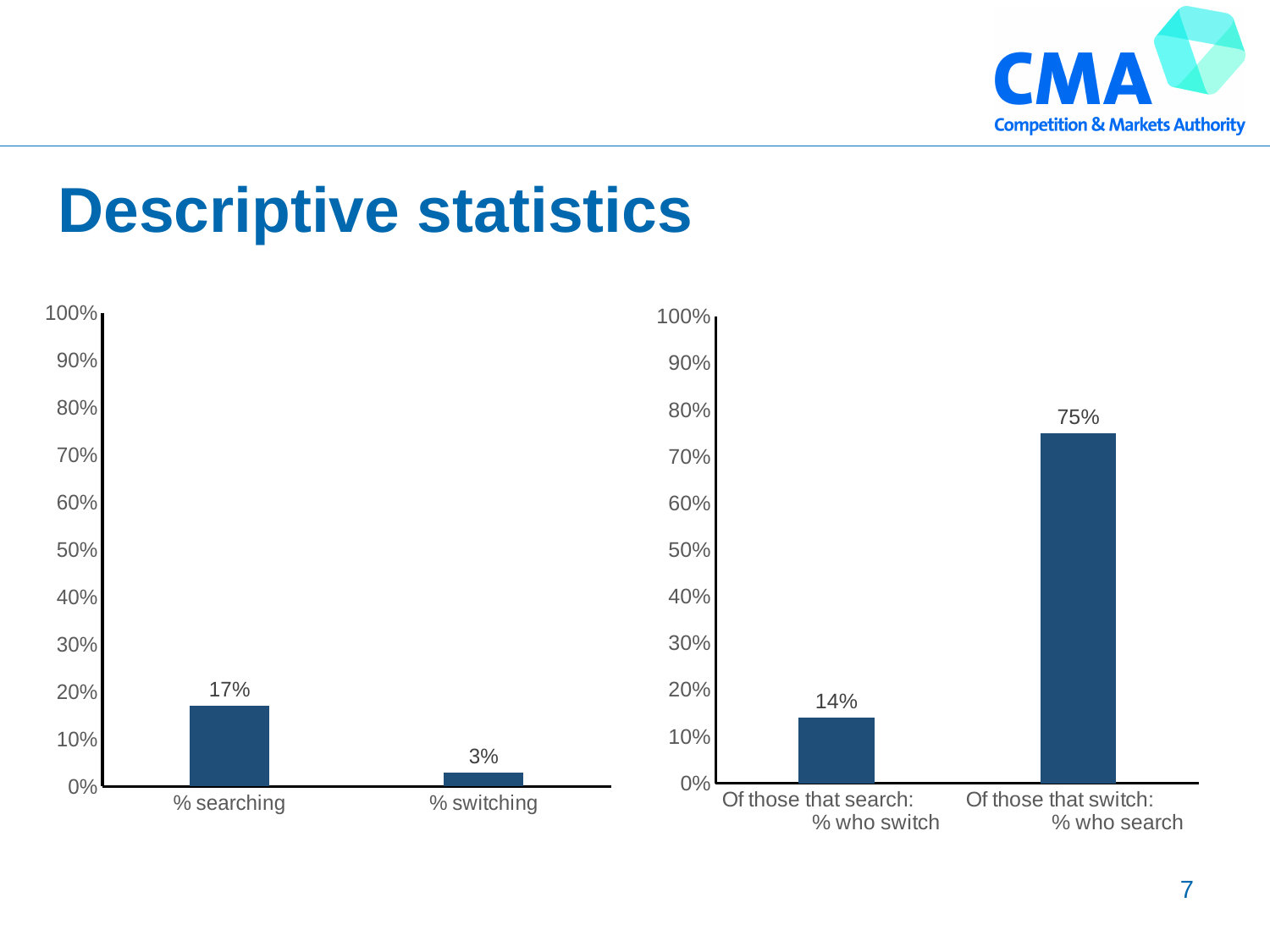
In the left chart, what is the value for % switching? 3% In the left chart, what is the difference between % searching and % switching? 14% How many bars are in the left chart? 2 In the right chart, is the value for 'Of those that switch: % who search' greater or less than 50%? greater In the left chart, which category has the highest value? % searching In the left chart, what is the value for % searching? 17% What is the title of the slide? Descriptive statistics In the right chart, which category has the lowest value? Of those that search: % who switch In the right chart, what is the difference between the two bars? 61% In the right chart, what is the value for 'Of those that search: % who switch'? 14% What kind of chart is the right chart? bar chart In the right chart, what is the value for 'Of those that switch: % who search'? 75%